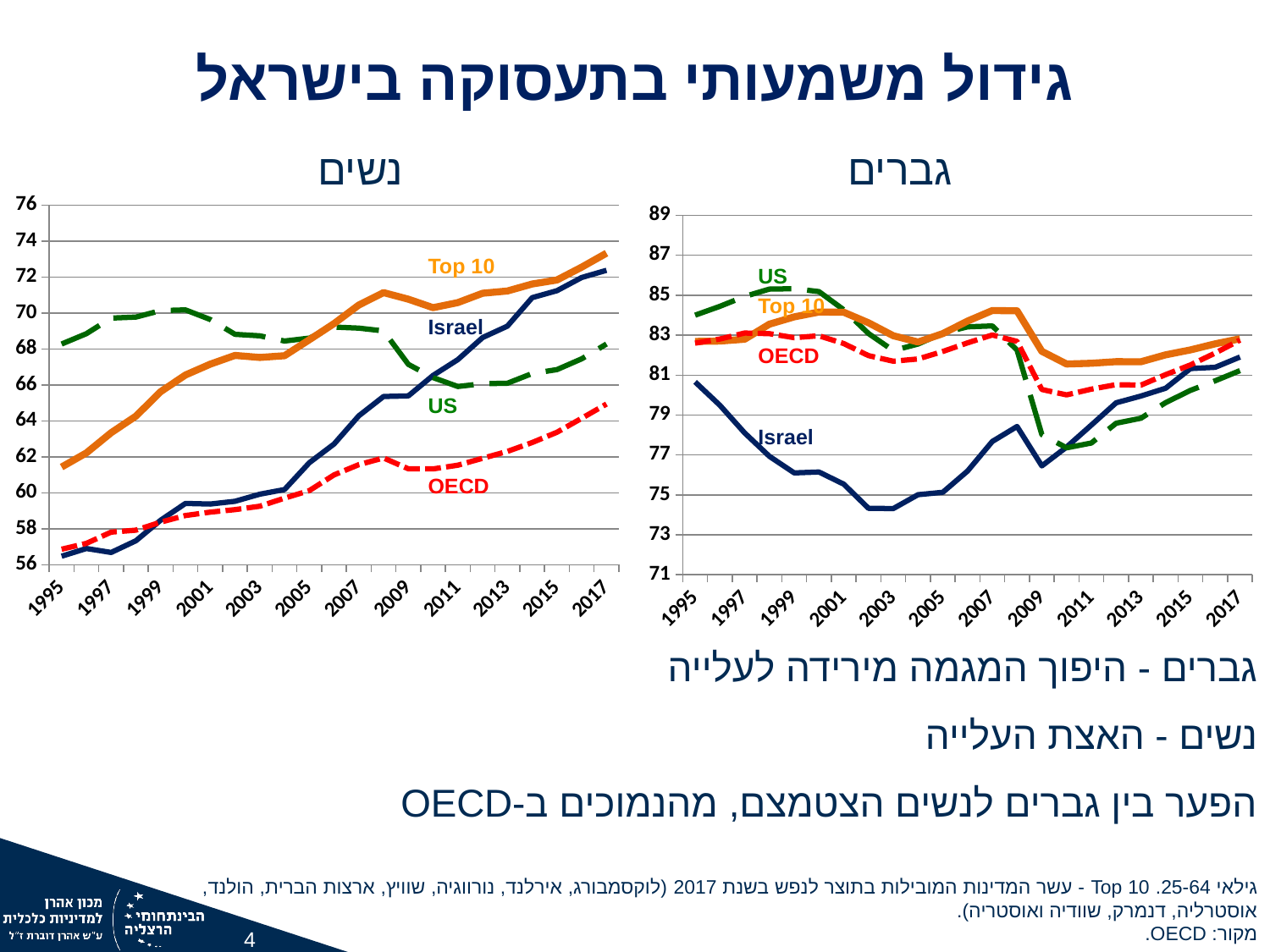
What is the title of the right chart? גברים On the left chart (נשים), which series has the lowest value in 2017? OECD On the left chart (נשים), which is higher in 1995, US or Israel? US On the right chart (גברים), is the value for Israel in 2003 greater or less than 75? less On the left chart (נשים), is the value for Israel in 2017 greater or less than 70? greater On the right chart (גברים), is the value for Israel in 1995 greater or less than 79? greater On the right chart (גברים), which is higher in 2009, Israel or OECD? OECD On the left chart (נשים), which is higher in 2017, Top 10 or OECD? Top 10 What kind of chart is the left chart (נשים)? line chart How many series are labelled on the right chart (גברים)? 4 On the left chart (נשים), does the Israel line rise or fall overall from 1995 to 2017? rise